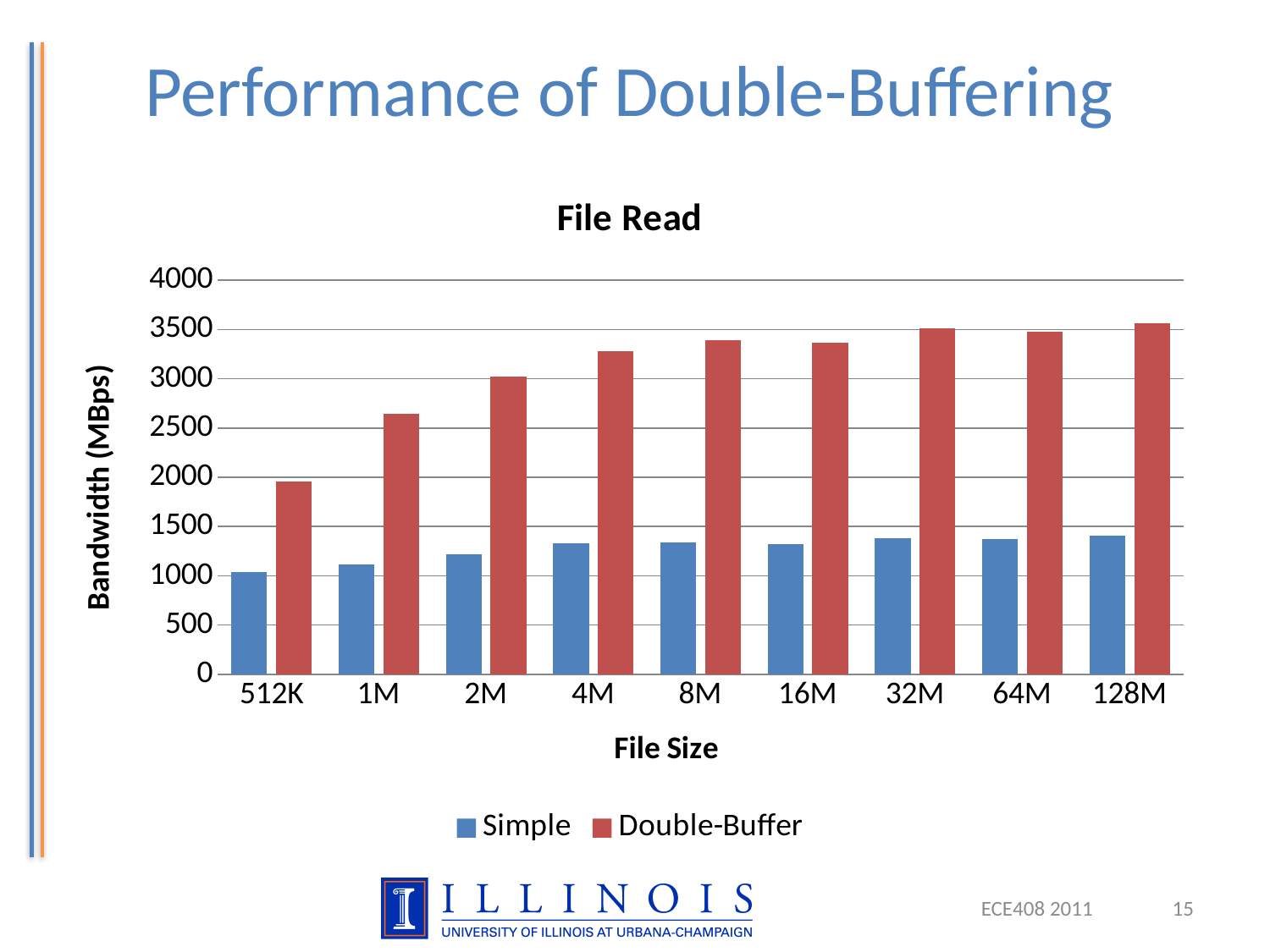
How many series does the legend of the File Read chart list? 2 At a file size of 16M, which series has the higher bandwidth, Simple or Double-Buffer? Double-Buffer What kind of chart is shown on the slide? bar chart Is the Double-Buffer bandwidth for 512K greater or less than 2000? less Is the Double-Buffer bandwidth for 8M greater or less than 3500? less Does the Double-Buffer bandwidth generally rise or fall as file size increases from 512K to 128M? rise Which file size has the lowest Double-Buffer bandwidth? 512K Is the Simple bandwidth for 4M greater or less than 1500? less How many file sizes are shown on the x axis of the File Read chart? 9 Which file size has the lowest Simple bandwidth? 512K What is the label of the y axis of the File Read chart? Bandwidth (MBps)